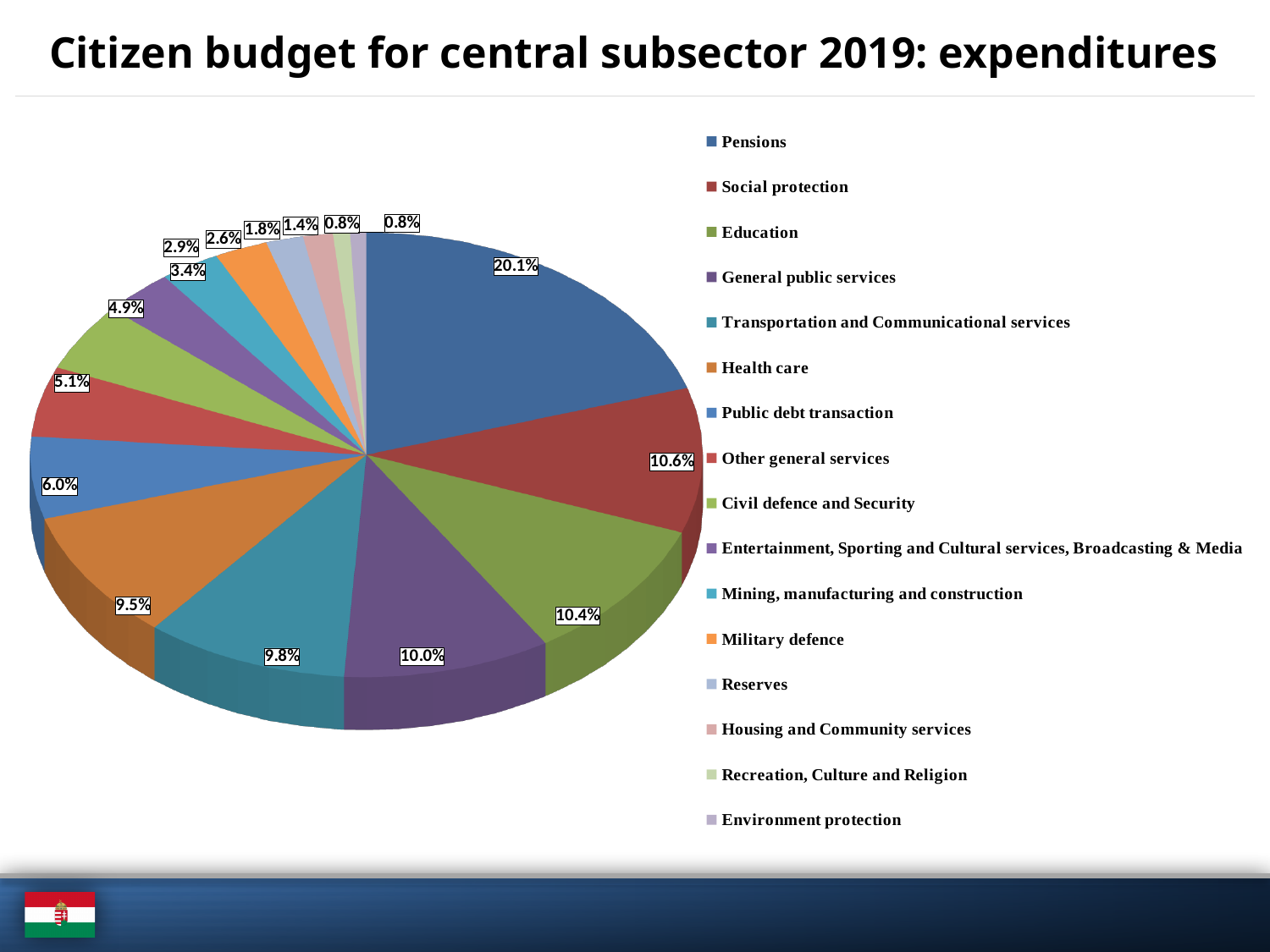
What is the difference between the Pensions share and the Social protection share? 9.5% What is the combined share of Reserves and Housing and Community services? 3.2% Which is larger, the share for Transportation and Communicational services or the share for Health care? Transportation and Communicational services What share is labelled for Health care? 9.5% What share of expenditures goes to Pensions? 20.1% What percentage is shown for Social protection? 10.6% How many categories does the pie chart show? 16 What is the title of the slide? Citizen budget for central subsector 2019: expenditures Which category has the largest share of expenditures? Pensions What kind of chart is shown on the slide? Pie chart What is the value for Education? 10.4% What percentage is shown for Public debt transaction? 6.0%